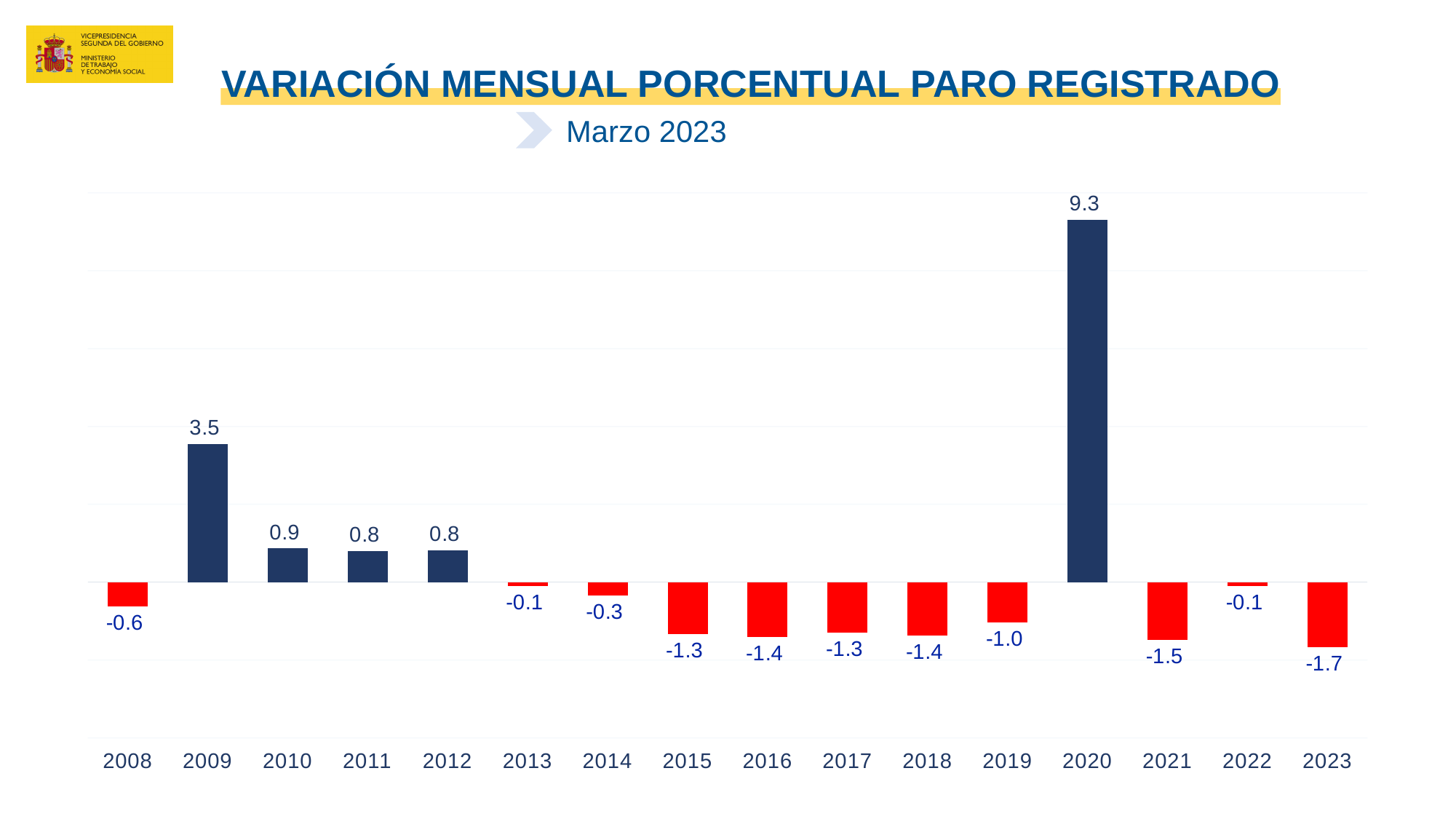
What is the value for 2020? 9.3 What is the value for 2009? 3.5 What is the value for 2023? -1.7 Which year has the lowest value? 2023 How many years are shown on the x axis? 16 What colour are the bars with negative values? Red Which year has the highest value? 2020 What kind of chart is shown on the slide? Bar chart What is the value for 2016? -1.4 What is the title of the chart? VARIACIÓN MENSUAL PORCENTUAL PARO REGISTRADO Which is larger, the value for 2010 or the value for 2011? 2010 What is the difference between the values for 2020 and 2009? 5.8